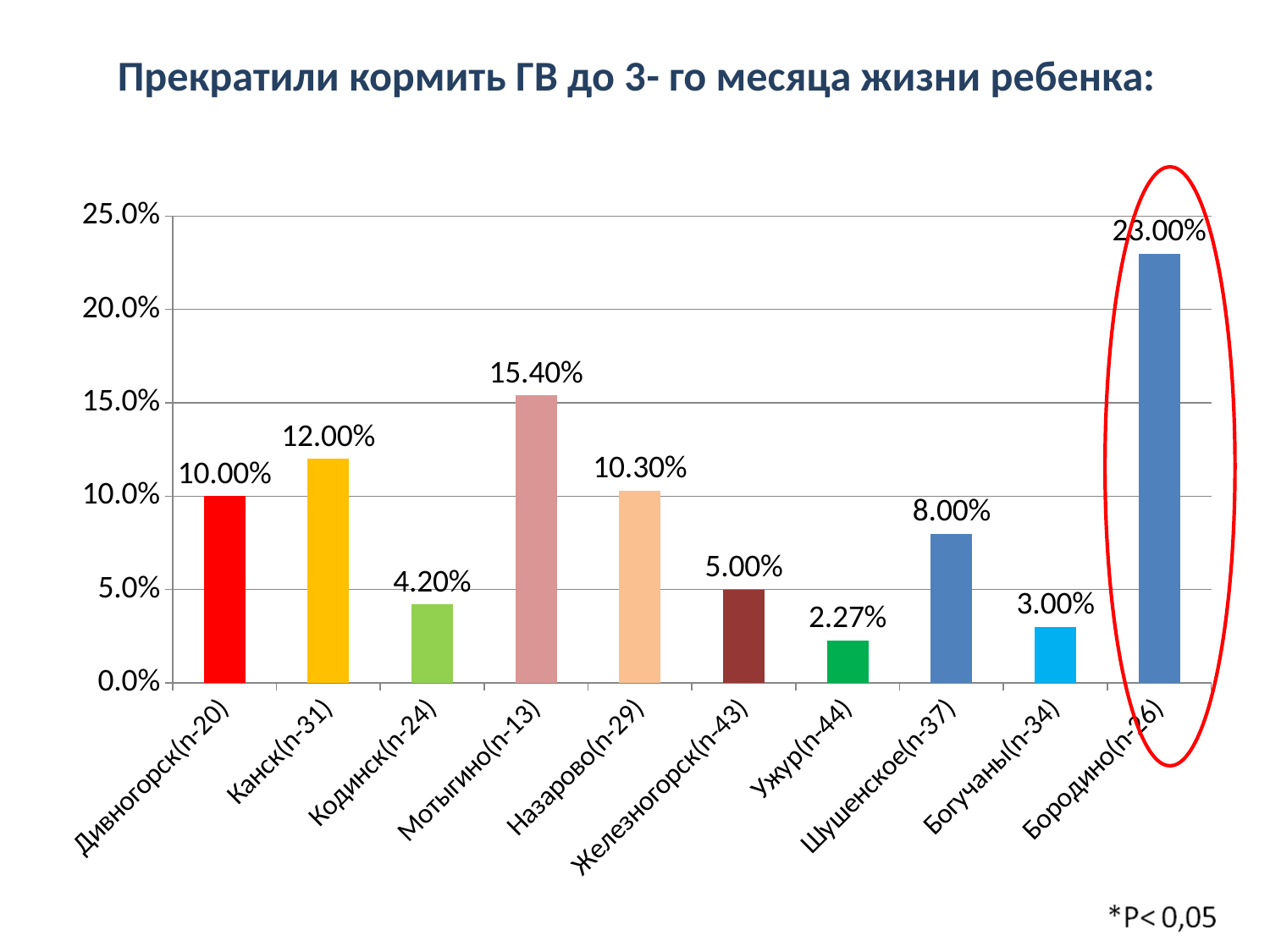
Is the value for Кодинск(n-24) greater or less than 5.0%? less What is the value for Бородино(n-26)? 23.00% How many categories are shown on the x axis? 10 What kind of chart is shown on the slide? bar chart Which category's bar is circled in red on the slide? Бородино(n-26) What is the value for Мотыгино(n-13)? 15.40% What is the difference between the values for Бородино(n-26) and Мотыгино(n-13)? 7.60% Which category has the highest value? Бородино(n-26) Which category has the lowest value? Ужур(n-44) What is the value for Ужур(n-44)? 2.27% What is the difference between the values for Канск(n-31) and Дивногорск(n-20)? 2.00% Which is larger, the value for Назарово(n-29) or the value for Шушенское(n-37)? Назарово(n-29)